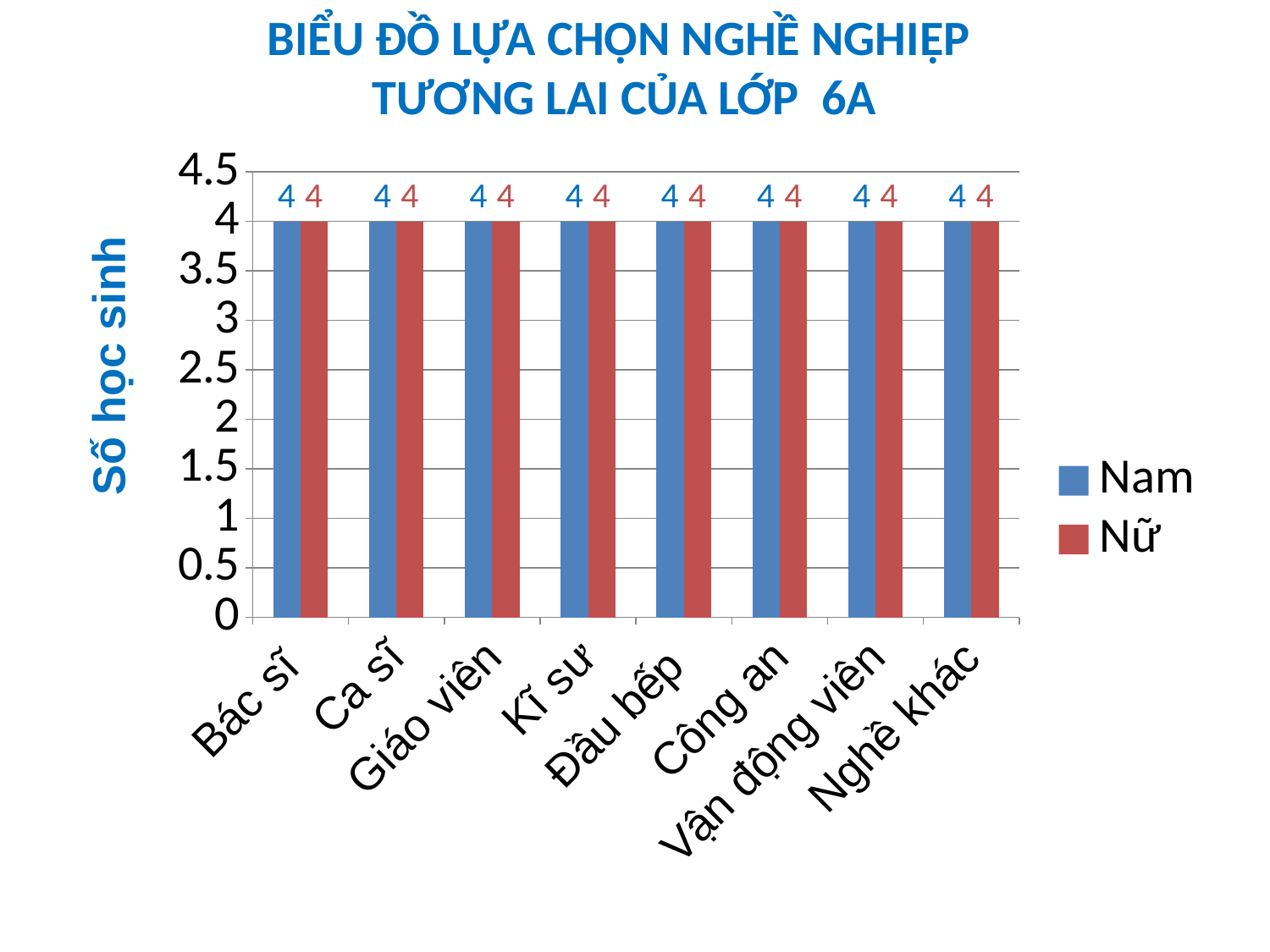
What kind of chart is shown on the slide? Bar chart What is the difference between the Nam and Nữ values for Kĩ sư? 0 What is the value for Nữ in the Giáo viên category? 4 Is the value for Nữ in the Vận động viên category greater or less than 3? greater What is the difference between the Nam value for Ca sĩ and the Nam value for Đầu bếp? 0 Is the value for Nam in the Ca sĩ category greater or less than 4.5? less How many series does the legend list? 2 What is the value for Nam in the Nghề khác category? 4 How many categories are shown on the x axis? 8 What is the value for Nam in the Bác sĩ category? 4 What is the value for Nữ in the Công an category? 4 What is the label of the vertical axis? Số học sinh